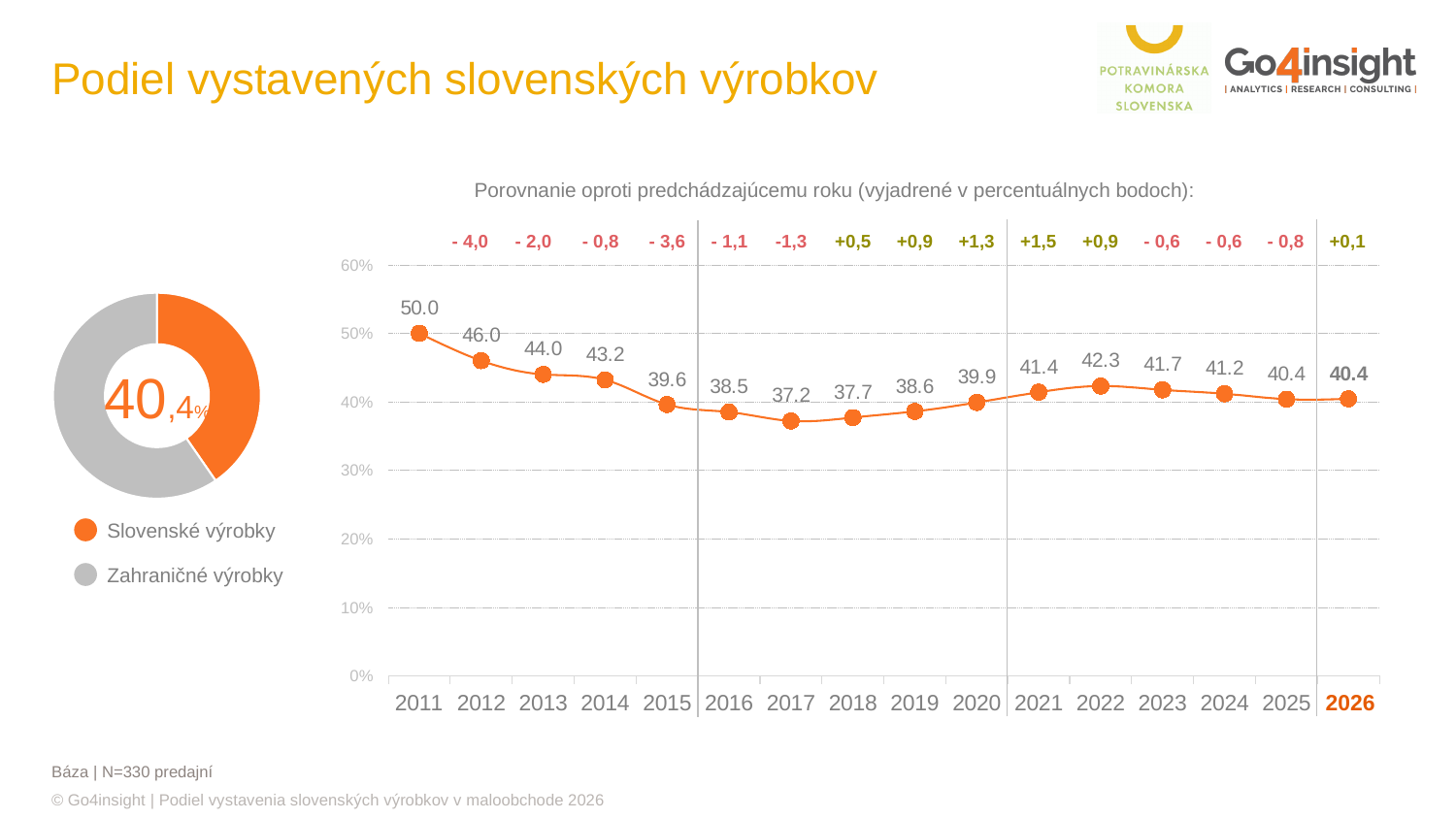
In the donut chart on the left, what share does the Slovenské výrobky slice represent? 40,4% In the line chart on the right, what is the difference between the values for 2011 and 2026? 9.6 In the line chart on the right, which year has the larger value, 2022 or 2023? 2022 In the line chart on the right, which year has the highest value? 2011 What kind of chart is the chart on the right of the slide? line chart In the line chart on the right, is the value for 2014 greater or less than 40%? greater In the line chart on the right, what is the value for 2011? 50.0 In the line chart on the right, do the values rise or fall from 2011 to 2015? fall In the line chart on the right, what is the value for 2017? 37.2 How many years are plotted on the x axis of the line chart on the right? 16 What kind of chart is the chart on the left of the slide? pie chart (donut) In the line chart on the right, which year has the lowest value? 2017